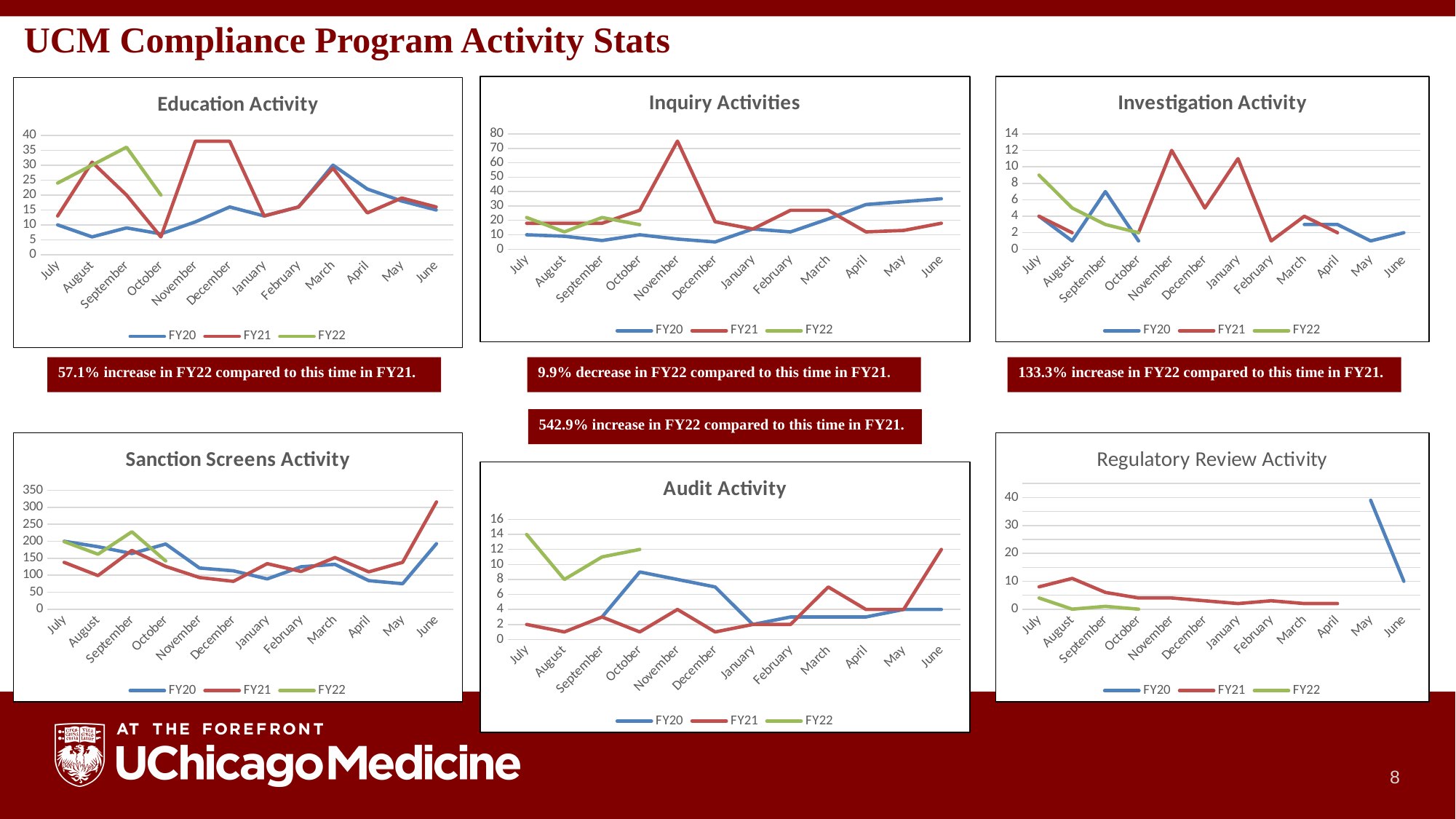
What kind of chart is the Education Activity chart? line chart In the Inquiry Activities chart, is the FY21 value for November greater or less than 60? greater In the Audit Activity chart, which series has the highest value in July? FY22 In the Sanction Screens Activity chart, which month has the highest FY21 value? June In the Audit Activity chart, is the FY22 value for July greater or less than 12? greater In the Regulatory Review Activity chart, is the FY20 value for May greater or less than 30? greater In the Inquiry Activities chart, which month has the highest FY21 value? November How many months are shown on the x axis of the Investigation Activity chart? 12 How many series does the legend of the Education Activity chart list? 3 In the Inquiry Activities chart, does the FY20 line rise or fall from March to June? rise